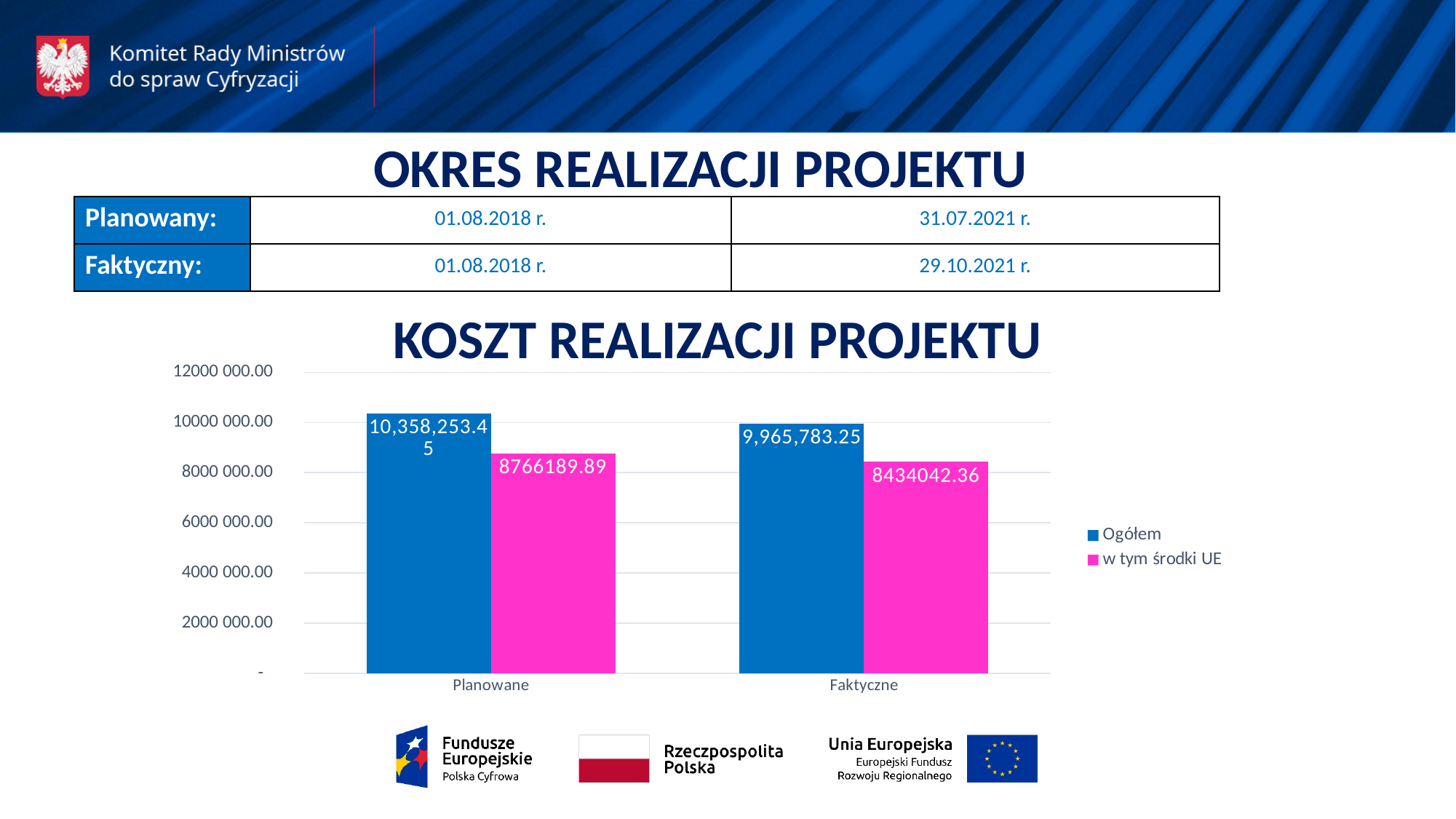
What is the value of the w tym środki UE bar for Planowane in the KOSZT REALIZACJI PROJEKTU chart? 8766189.89 What is the value of the w tym środki UE bar for Faktyczne in the KOSZT REALIZACJI PROJEKTU chart? 8434042.36 What is the value of the Ogółem bar for Planowane in the KOSZT REALIZACJI PROJEKTU chart? 10,358,253.45 In the KOSZT REALIZACJI PROJEKTU chart, is the Ogółem value for Planowane greater or less than 10000 000.00? greater What is the value of the Ogółem bar for Faktyczne in the KOSZT REALIZACJI PROJEKTU chart? 9,965,783.25 In the KOSZT REALIZACJI PROJEKTU chart, is the Ogółem value for Planowane or for Faktyczne larger? Planowane What type of chart is the KOSZT REALIZACJI PROJEKTU chart? bar chart Which bar in the KOSZT REALIZACJI PROJEKTU chart has the highest value? Ogółem for Planowane How many series does the legend of the KOSZT REALIZACJI PROJEKTU chart list? 2 How many categories are shown on the x axis of the KOSZT REALIZACJI PROJEKTU chart? 2 In the KOSZT REALIZACJI PROJEKTU chart, what is the difference between the Ogółem values for Planowane and Faktyczne? 392,470.20 Which bar in the KOSZT REALIZACJI PROJEKTU chart has the lowest value? w tym środki UE for Faktyczne